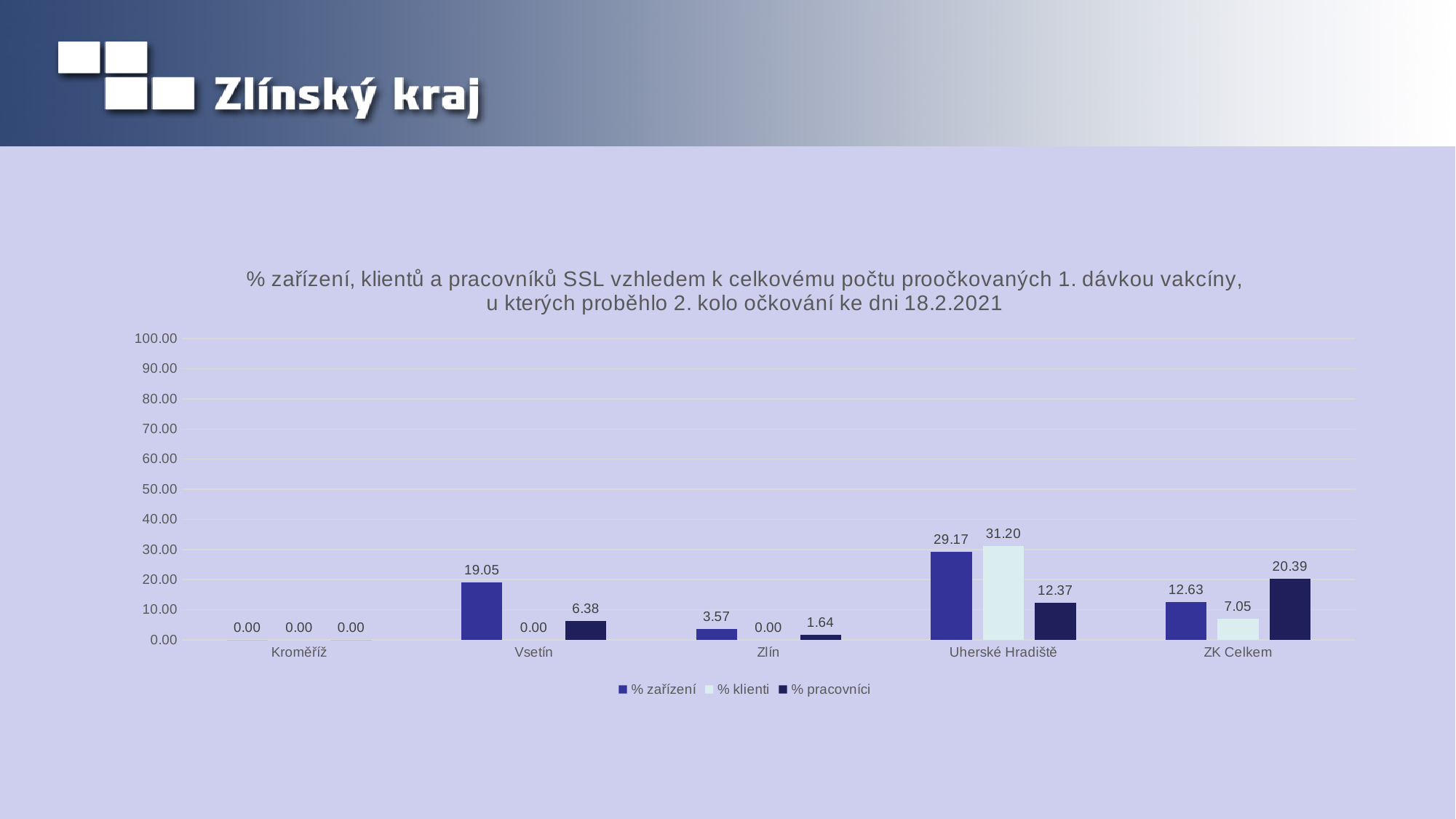
Which category has the highest value for % zařízení? Uherské Hradiště What is the value of % pracovníci for ZK Celkem? 20.39 Which is larger for ZK Celkem: % zařízení or % klienti? % zařízení What is the value of % klienti for Uherské Hradiště? 31.20 What is the difference between % klienti and % pracovníci for Uherské Hradiště? 18.83 How many series does the legend list? 3 What is the value of % zařízení for Vsetín? 19.05 What is the total of the three series values for Vsetín? 25.43 How many categories are shown on the x axis? 5 Which category has the lowest value for % pracovníci? Kroměříž What is the value of % pracovníci for Zlín? 1.64 What kind of chart is shown on the slide? Bar chart